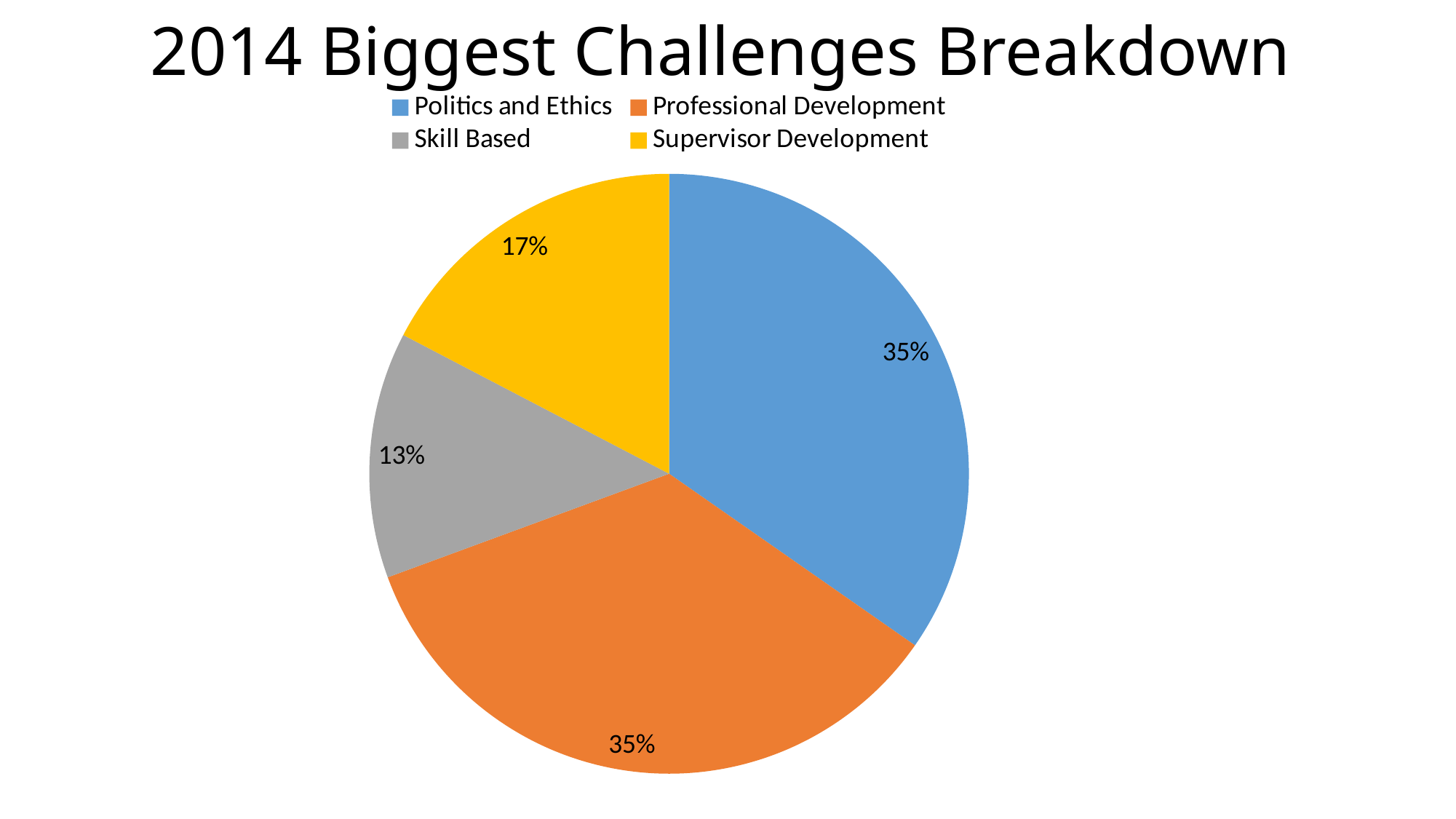
What is the difference between the Politics and Ethics share and the Supervisor Development share? 18% What colour is the Skill Based slice? Grey How many categories are shown in the pie chart? 4 What kind of chart is shown on the slide? Pie chart What share of the pie does Politics and Ethics represent? 35% What share of the pie does Supervisor Development represent? 17% What is the title of the chart? 2014 Biggest Challenges Breakdown Which is larger, the Supervisor Development slice or the Skill Based slice? Supervisor Development Which category has the smallest slice of the pie? Skill Based What share of the pie does Professional Development represent? 35% What is the difference between the Supervisor Development share and the Skill Based share? 4% What share of the pie does Skill Based represent? 13%